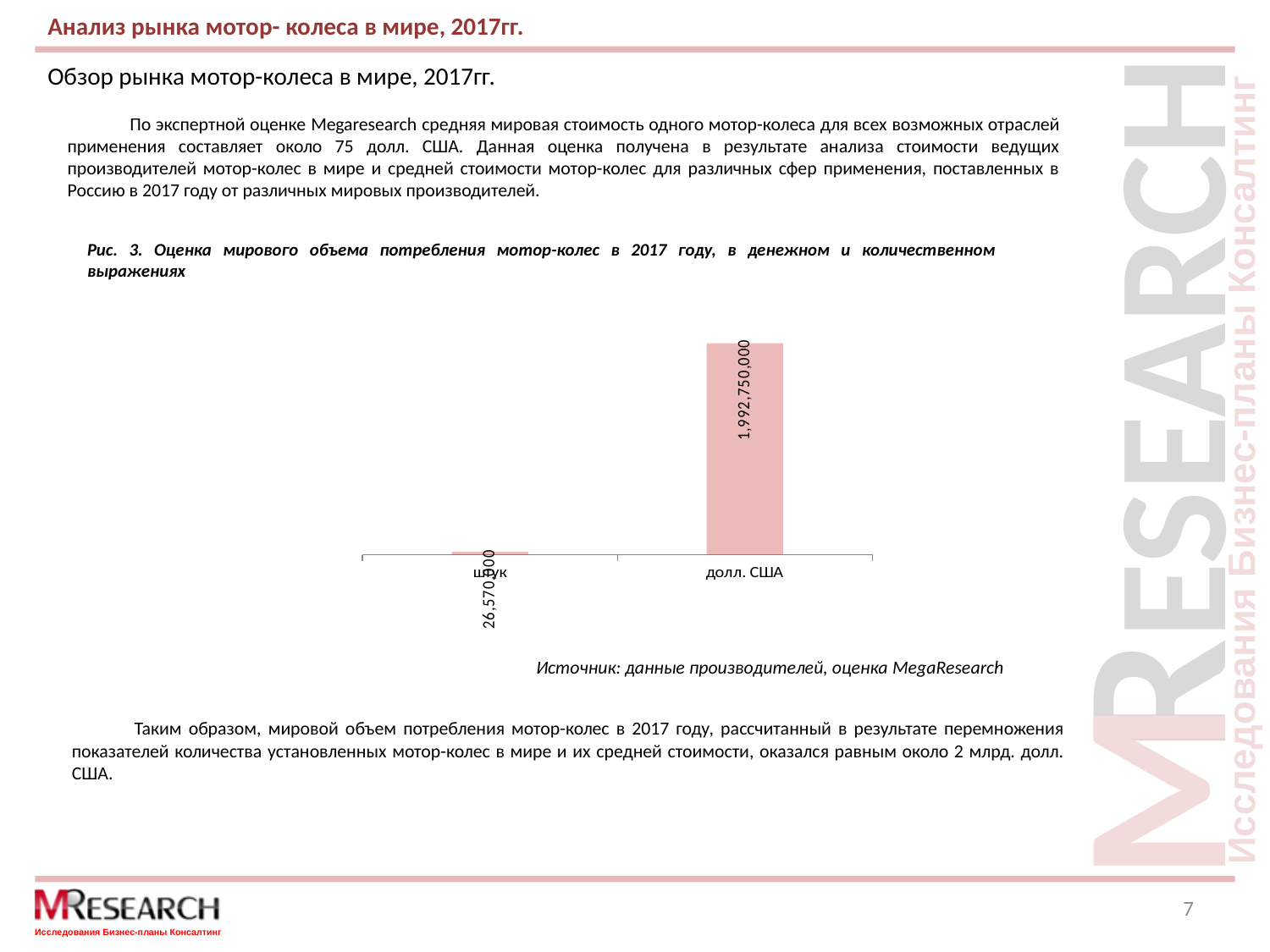
How many categories are plotted on the chart? 2 What is the value shown for the "Штук" bar? 26,570,000 Is the value for "долл. США" larger or smaller than the value for "Штук"? larger What type of chart is shown on the slide? bar chart What is the figure caption (title) of the chart? Рис. 3. Оценка мирового объема потребления мотор-колес в 2017 году, в денежном и количественном выражениях What source is cited below the chart? Источник: данные производителей, оценка MegaResearch What is the difference between the "долл. США" value and the "Штук" value? 1,966,180,000 Which category has the taller bar? долл. США What is the value shown for the "долл. США" bar? 1,992,750,000 Which category has the shorter bar? Штук